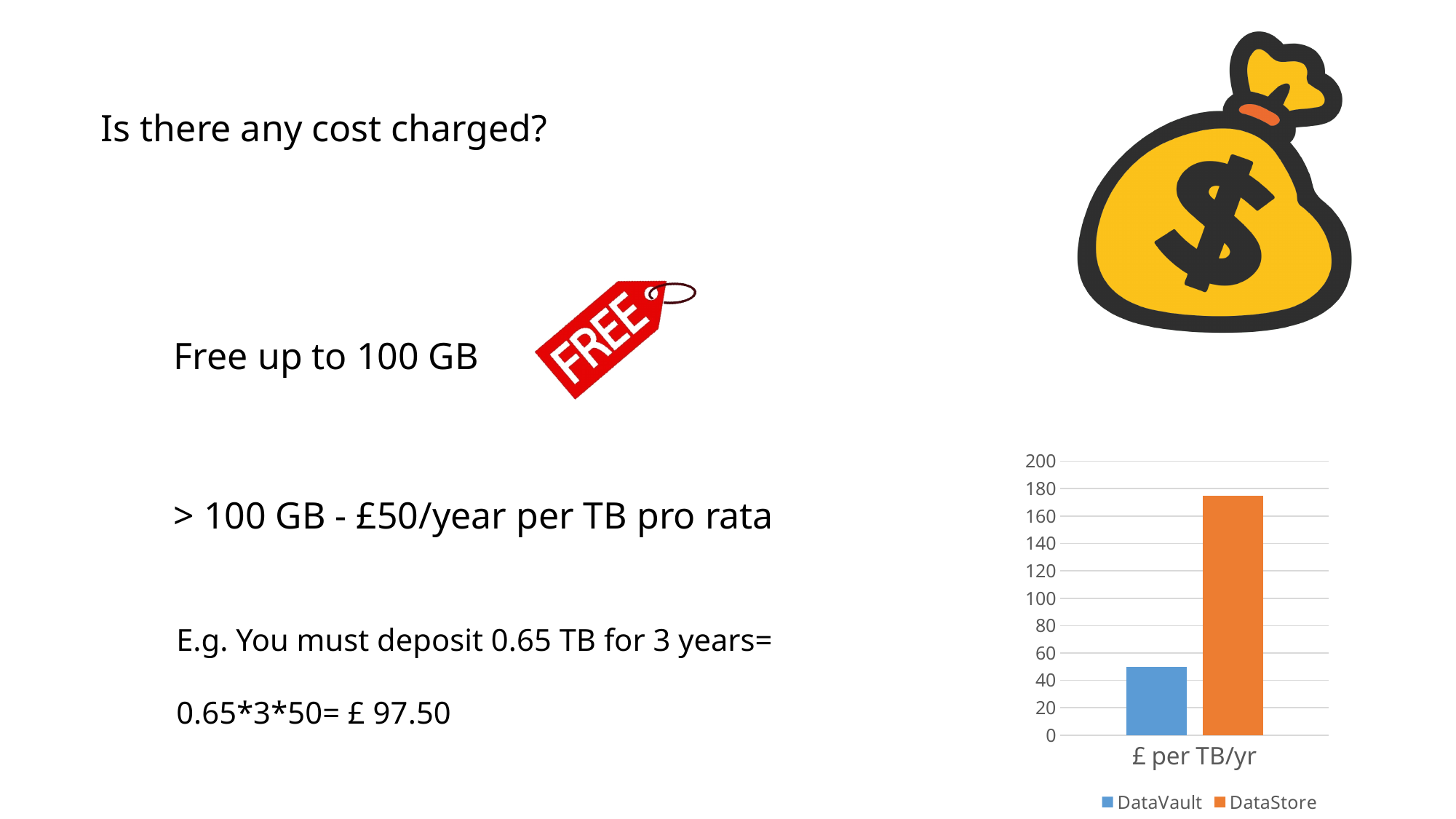
Is the value for DataStore greater or less than 180? less What kind of chart is shown on the slide? bar chart Which series has the lowest bar in the chart? DataVault Is the value for DataStore greater or less than 160? greater What is the category label shown on the x axis of the chart? £ per TB/yr How many series does the chart legend list? 2 How many categories are shown on the x axis of the chart? 1 Is the value for DataVault greater or less than 40? greater Which series has the higher value for £ per TB/yr, DataVault or DataStore? DataStore What colour is the DataStore bar in the chart? orange Which series has the highest bar in the chart? DataStore